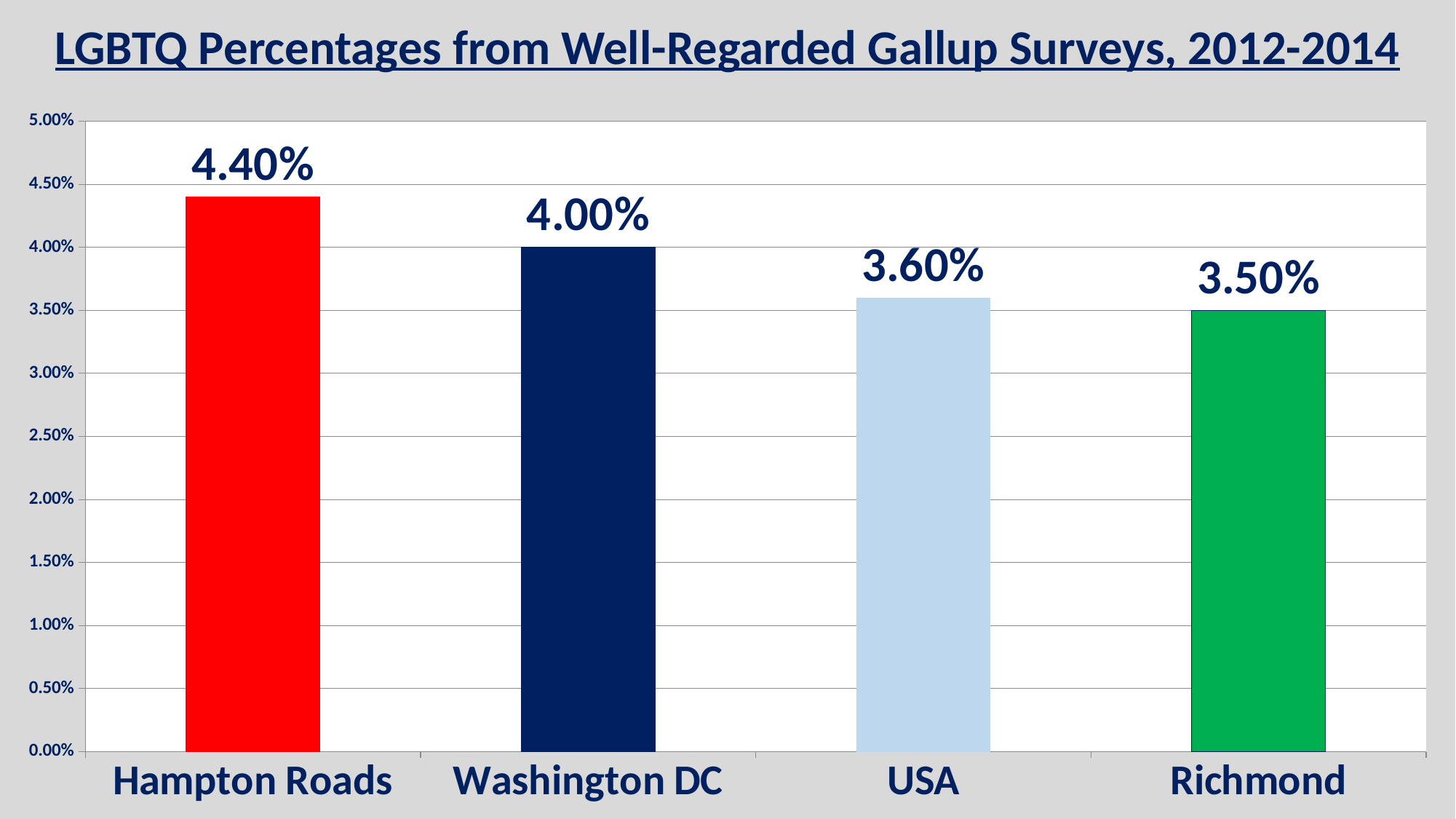
What is the LGBTQ percentage for Hampton Roads? 4.40% What is the LGBTQ percentage for Washington DC? 4.00% What is the title of the chart? LGBTQ Percentages from Well-Regarded Gallup Surveys, 2012-2014 How many categories are shown in the chart? 4 Which is larger, the value for Washington DC or the value for USA? Washington DC What is the LGBTQ percentage for the USA? 3.60% What is the difference between the Hampton Roads and Washington DC percentages? 0.40% Which category has the highest LGBTQ percentage? Hampton Roads What kind of chart is shown on the slide? Bar chart What is the LGBTQ percentage for Richmond? 3.50% Which category has the lowest LGBTQ percentage? Richmond What is the difference between the USA and Richmond percentages? 0.10%